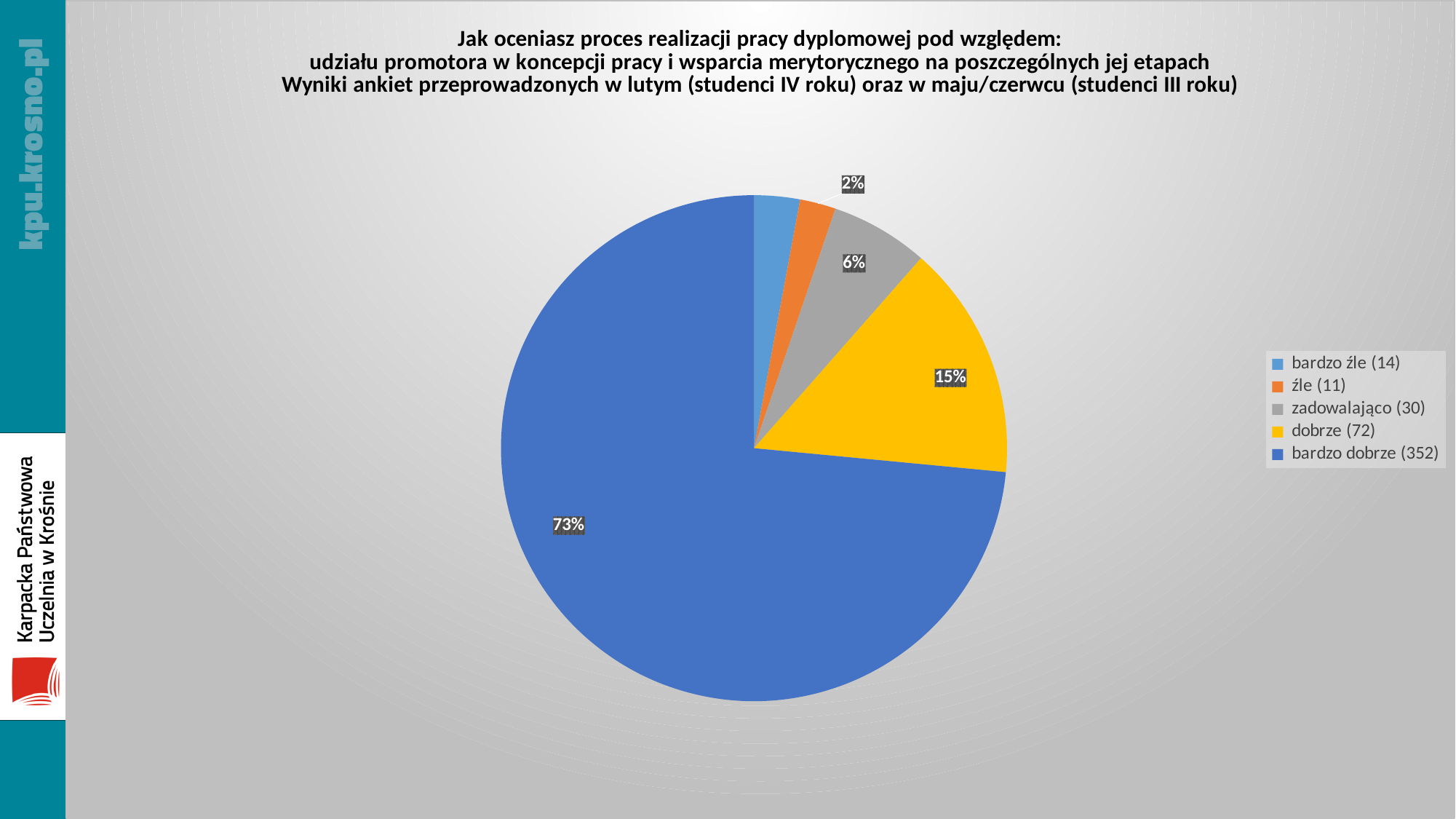
Which category has the smallest number of responses according to the legend? źle Which colour is used for the 'dobrze' slice? yellow What is the difference in responses between 'bardzo dobrze' (352) and 'dobrze' (72)? 280 What percentage share does the 'zadowalająco' slice have? 6% How many responses does the legend give for 'bardzo dobrze'? 352 How many responses does the legend give for 'zadowalająco'? 30 What percentage share does the 'bardzo dobrze' slice have? 73% How many categories does the legend of the pie chart list? 5 How many responses does the legend give for 'bardzo źle'? 14 Which category has the largest slice of the pie? bardzo dobrze What kind of chart is shown on the slide? pie chart What percentage share does the 'dobrze' slice have? 15%